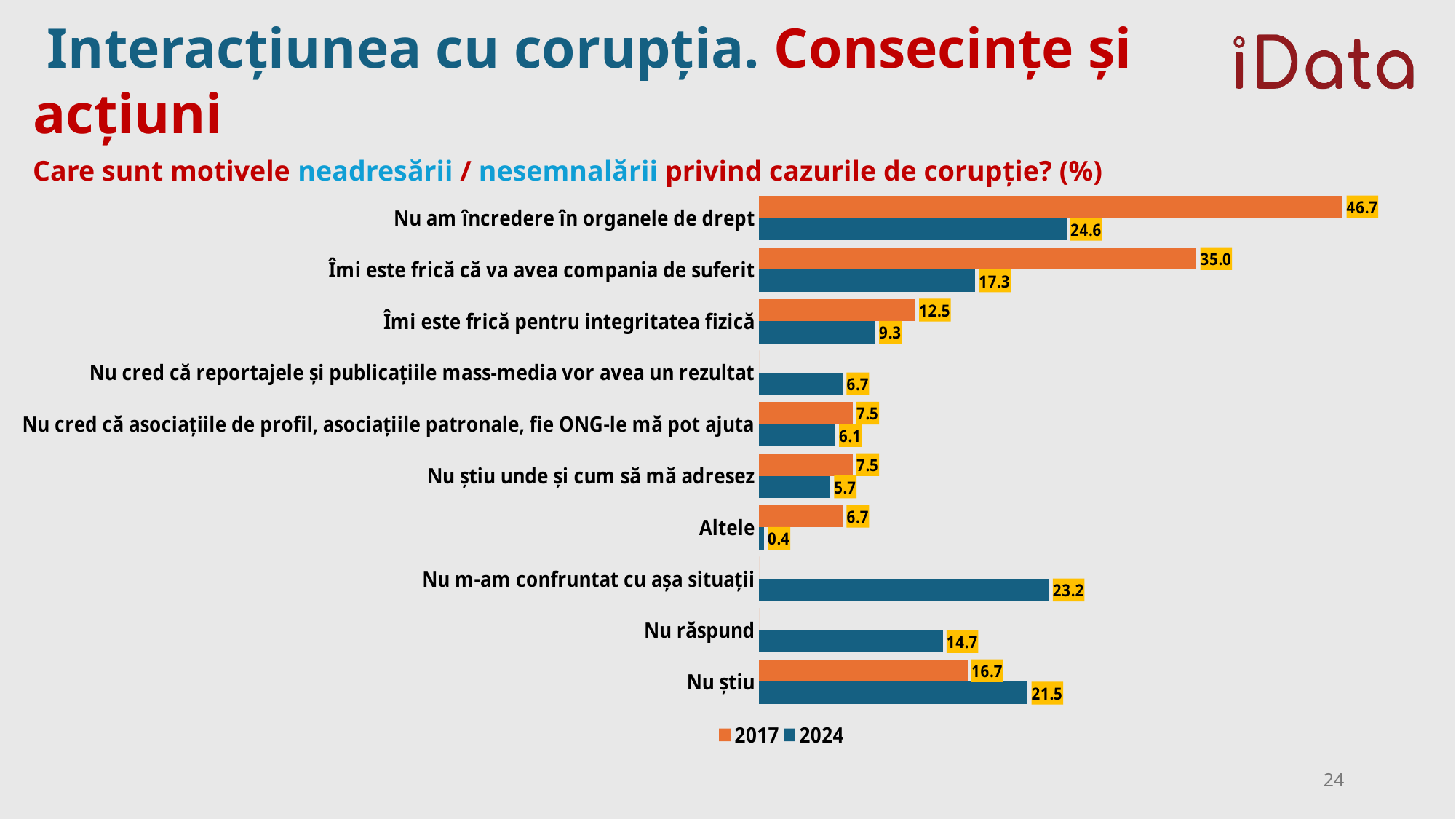
How many series does the legend list? 2 Which category has the highest 2017 value? Nu am încredere în organele de drept What type of chart is shown on the slide? Bar chart What is the 2024 value for "Nu m-am confruntat cu așa situații"? 23.2 What is the 2024 value for "Îmi este frică că va avea compania de suferit"? 17.3 What is the difference between the 2017 and 2024 values for "Nu am încredere în organele de drept"? 22.1 How many categories are shown on the chart? 10 What is the difference between the 2024 and 2017 values for "Nu știu"? 4.8 Which category has the lowest 2024 value? Altele Which is larger for "Îmi este frică pentru integritatea fizică": the 2017 value or the 2024 value? 2017 What is the 2017 value for "Nu am încredere în organele de drept"? 46.7 Which is larger for "Nu știu": the 2017 value or the 2024 value? 2024